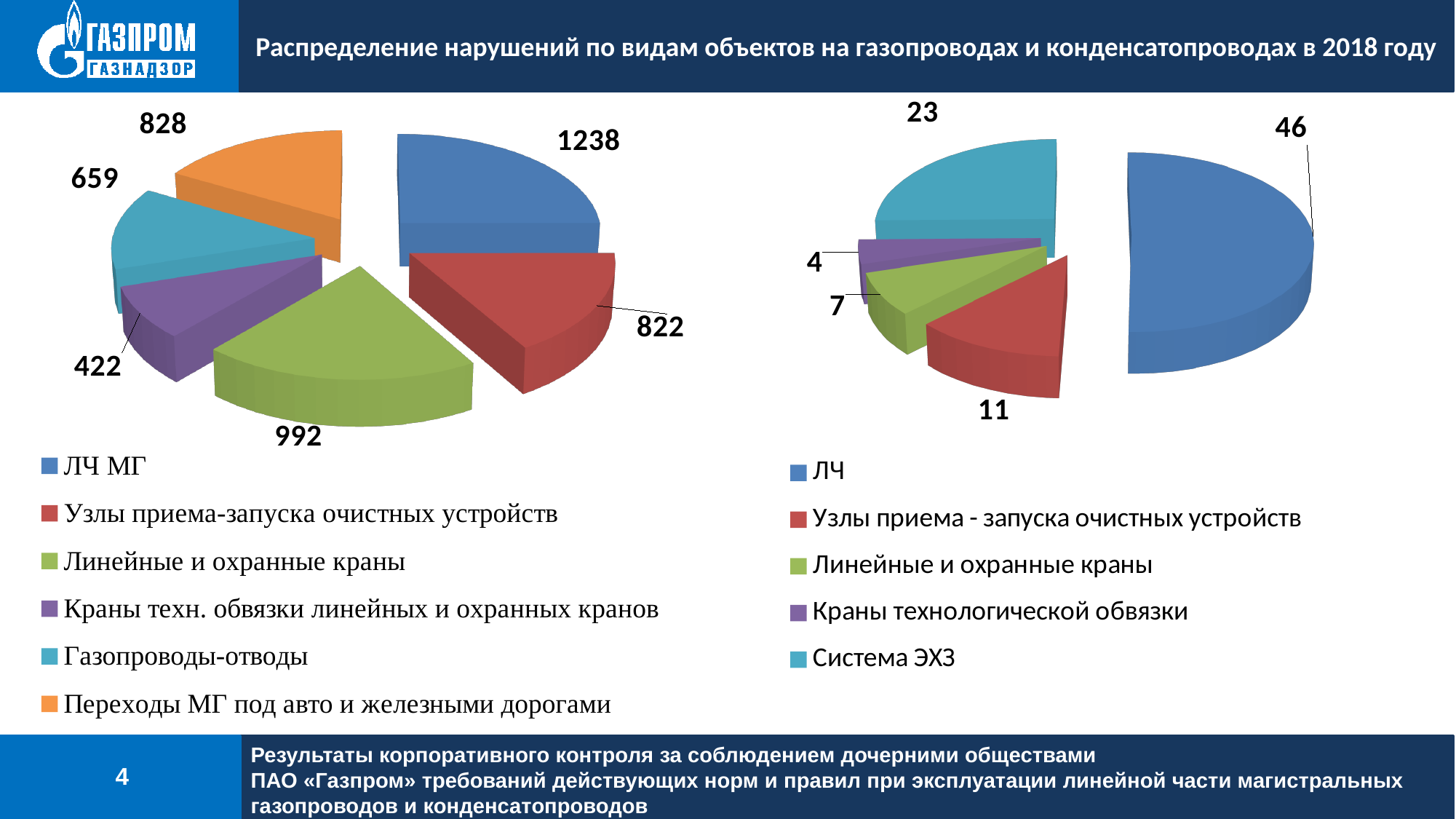
In the right pie chart, which category has the lowest value? Краны технологической обвязки How many categories does the right pie chart's legend list? 5 In the left pie chart, what is the difference between Линейные и охранные краны and Узлы приема-запуска очистных устройств? 170 In the left pie chart, what is the value for ЛЧ МГ? 1238 In the left pie chart, which category has the highest value? ЛЧ МГ In the right pie chart, what is the value for Краны технологической обвязки? 4 In the left pie chart, which category has the lowest value? Краны техн. обвязки линейных и охранных кранов In the left pie chart, which is larger: Переходы МГ под авто и железными дорогами or Газопроводы-отводы? Переходы МГ под авто и железными дорогами In the left pie chart, what is the value for Газопроводы-отводы? 659 What type of chart is the left chart? Pie chart In the right pie chart, what is the difference between ЛЧ and Система ЭХЗ? 23 In the right pie chart, what is the value for Система ЭХЗ? 23